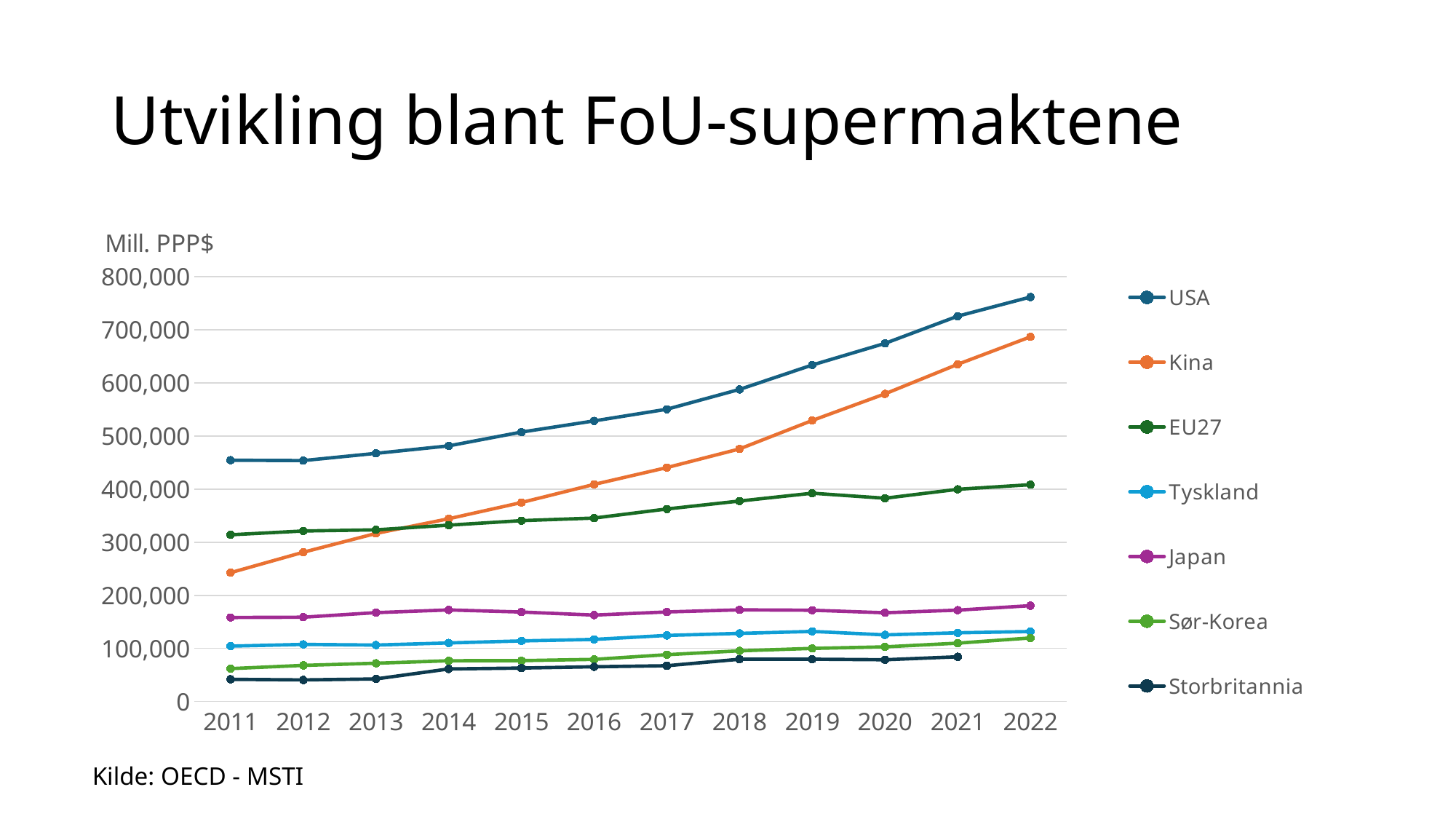
What unit label is shown above the y axis? Mill. PPP$ Is the value for Japan in 2022 greater or less than 200,000? less How many series does the legend list? 7 Which is larger in 2022, Kina or EU27? Kina What kind of chart is shown on the slide? line chart Is the value for USA in 2022 greater or less than 700,000? greater Is the value for Kina in 2011 greater or less than 300,000? less Does the Kina series rise or fall from 2011 to 2022? rise How many years are shown along the x axis? 12 Which series has the lowest value in 2011? Storbritannia Which series has the highest value in 2022? USA Which is larger in 2011, Kina or EU27? EU27